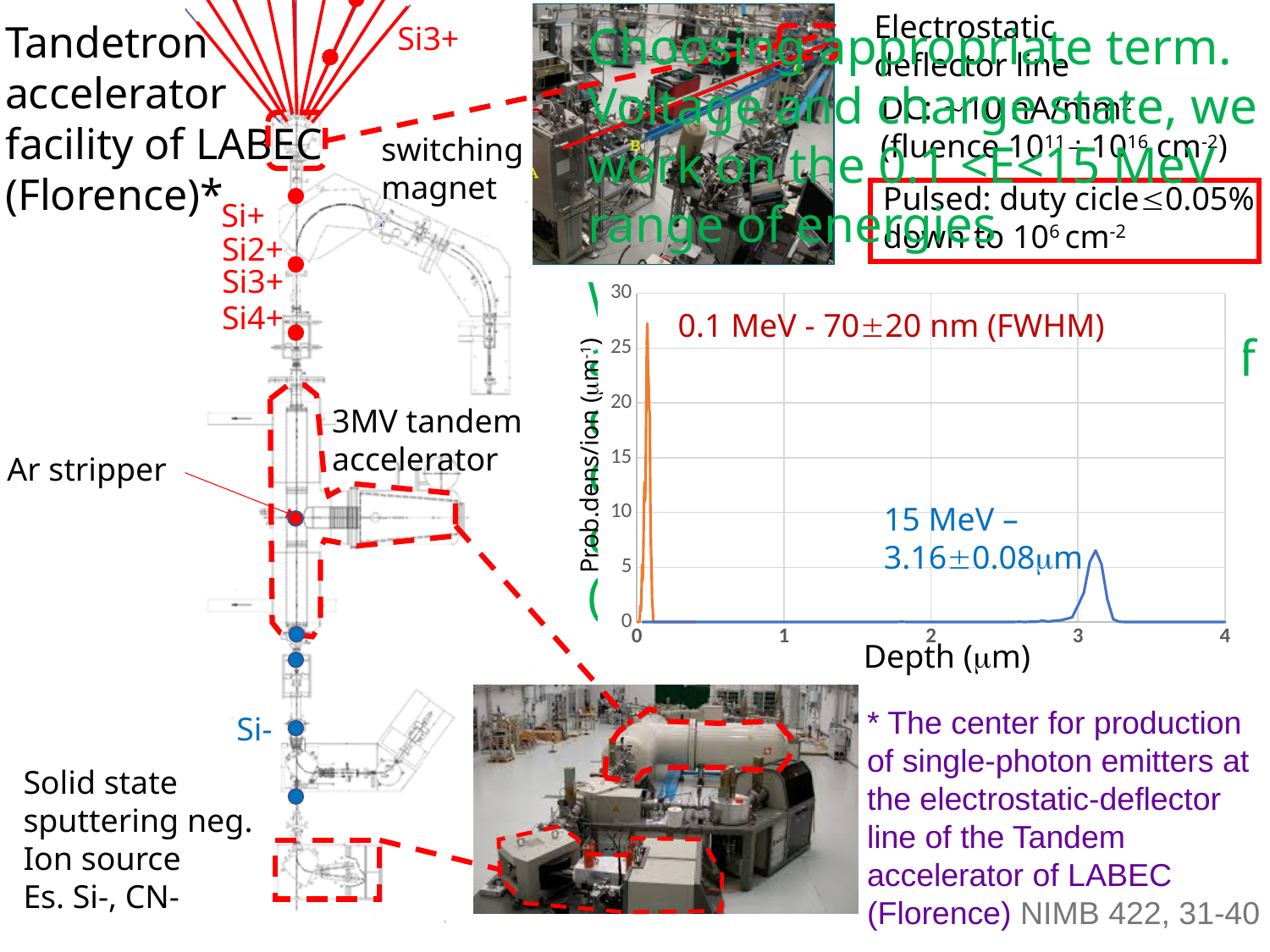
Is the peak value of the 15 MeV curve greater or less than 5? greater Is the peak value of the 0.1 MeV curve greater or less than 25? greater How many curves are plotted on the chart? 2 What is the maximum value shown on the x axis of the chart? 4 What is the label of the x axis of the chart? Depth (μm) Is the peak of the 15 MeV curve located at a depth greater or less than 3 μm? greater According to the chart annotation, what is the depth for the 15 MeV curve? 3.16±0.08 μm Which curve has the higher peak, the 0.1 MeV curve or the 15 MeV curve? 0.1 MeV According to the chart annotation, what is the FWHM for the 0.1 MeV curve? 70±20 nm What kind of chart is shown on the slide? line chart What is the label of the y axis of the chart? Prob.dens/ion (μm⁻¹)